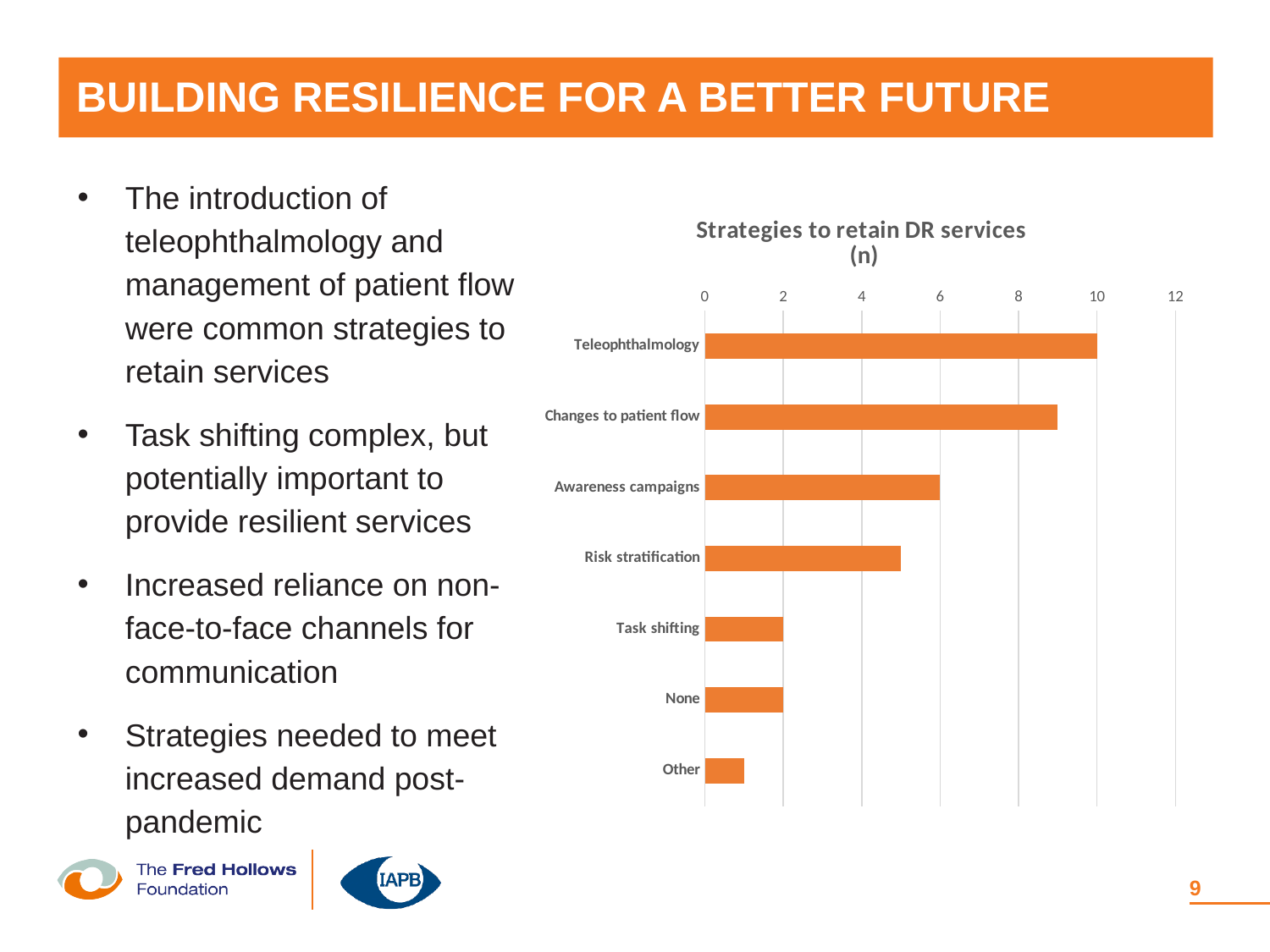
Is the value for Risk stratification greater or less than 6? less What type of chart is shown on the slide? bar chart Which strategy has the highest value in the chart? Teleophthalmology What is the value for Teleophthalmology? 10 What is the value for Awareness campaigns? 6 Which has a larger value, Changes to patient flow or Risk stratification? Changes to patient flow Is the value for Changes to patient flow greater or less than 8? greater What is the value for Task shifting? 2 How many strategy categories are plotted in the chart? 7 What is the difference between the values for Teleophthalmology and Awareness campaigns? 4 What is the title of the chart? Strategies to retain DR services (n) Which strategy has the lowest value in the chart? Other